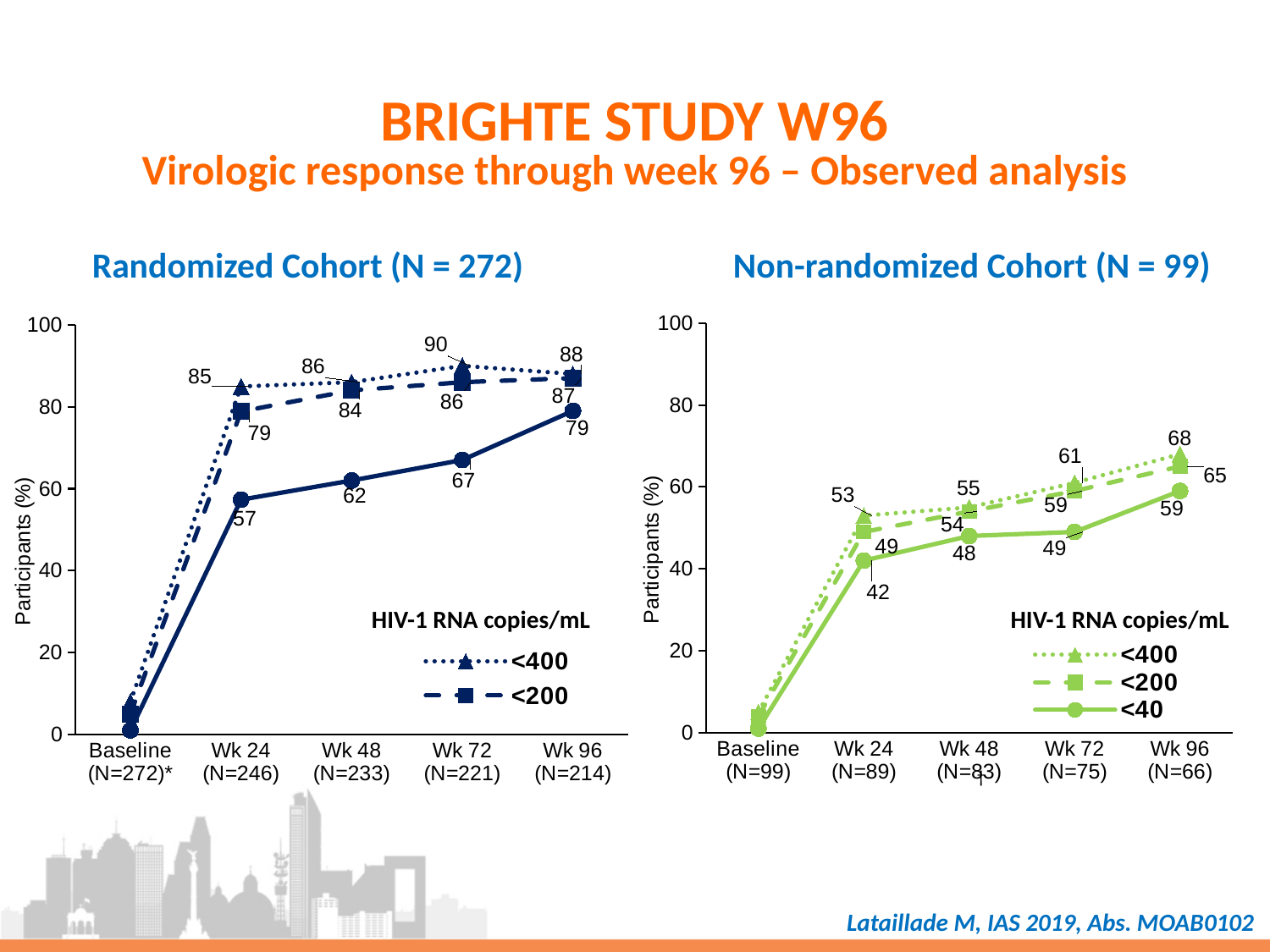
In the Randomized Cohort chart, what is the difference between the <400 and <40 values at Wk 96? 9 In the Randomized Cohort chart, which series has the larger value at Wk 24, <400 or <40? <400 In the Randomized Cohort chart, what is the value for the <400 series at Wk 72? 90 In the Randomized Cohort chart, at which time point does the <400 series reach its highest value? Wk 72 In the Randomized Cohort chart, what is the value for the <40 series at Wk 96? 79 What kind of chart is the Randomized Cohort chart? Line chart In the Non-randomized Cohort chart, what is the difference between the <400 and <40 values at Wk 96? 9 In the Non-randomized Cohort chart, what is the value for the <40 series at Wk 24? 42 In the Non-randomized Cohort chart, what is the value for the <400 series at Wk 96? 68 How many time points are plotted on the x axis of the Non-randomized Cohort chart? 5 In the Non-randomized Cohort chart, does the <40 series rise or fall from Wk 24 to Wk 96? Rise How many series does the legend of the Non-randomized Cohort chart list? 3